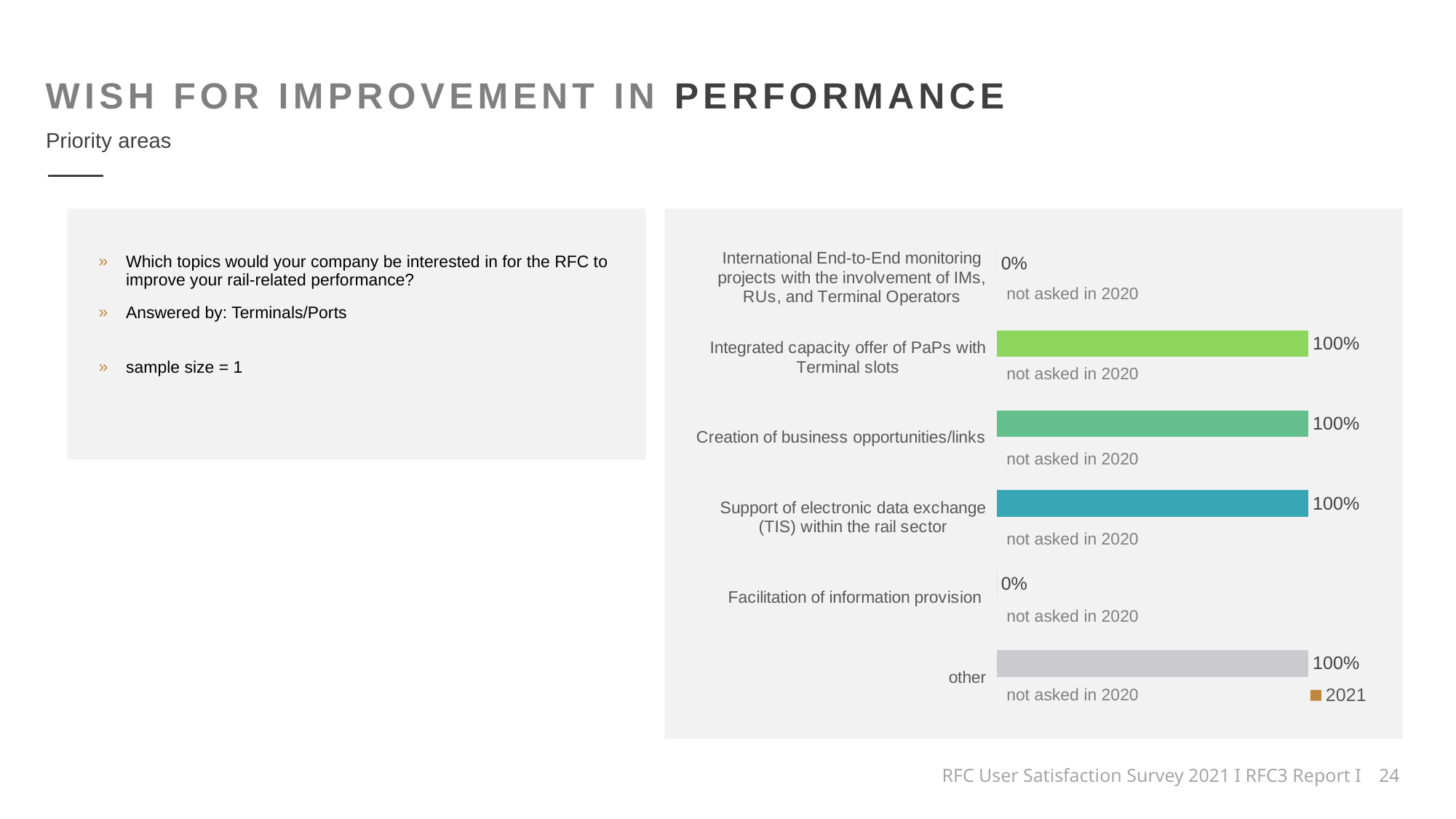
What is the 2021 value for 'Facilitation of information provision'? 0% What is the 2021 value for 'Integrated capacity offer of PaPs with Terminal slots'? 100% What is the 2021 value for 'other'? 100% What is the difference between the 2021 values for 'Support of electronic data exchange (TIS) within the rail sector' and 'Facilitation of information provision'? 100% What series does the legend list? 2021 How many categories are shown in the chart? 6 What kind of chart is shown on the slide? bar chart What is the 2021 value for 'Creation of business opportunities/links'? 100% How many series does the legend list? 1 Which is larger in 2021: 'Creation of business opportunities/links' or 'Facilitation of information provision'? Creation of business opportunities/links What is the 2021 value for 'International End-to-End monitoring projects with the involvement of IMs, RUs, and Terminal Operators'? 0% What text appears under each bar regarding the 2020 data? not asked in 2020